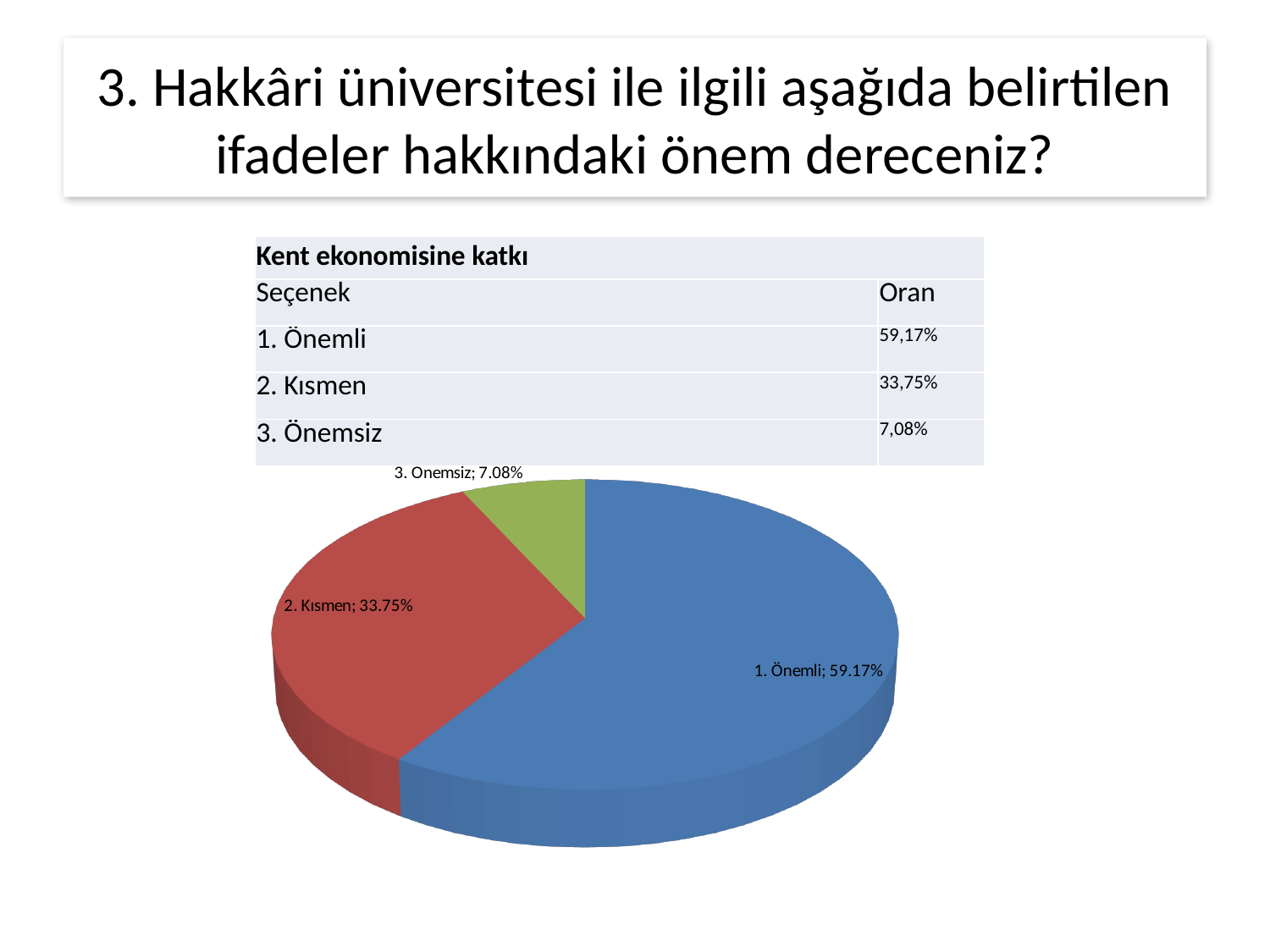
What is the value shown for the "1. Önemli" slice of the pie chart? 59.17% What is the difference between the "1. Önemli" and "2. Kısmen" values in the pie chart? 25.42% Which slice of the pie chart is the largest? 1. Önemli How many slices does the pie chart have? 3 Which is larger in the pie chart, "2. Kısmen" or "3. Onemsiz"? 2. Kısmen Which slice of the pie chart is the smallest? 3. Onemsiz What colour is the "2. Kısmen" slice in the pie chart? red What is the value shown for the "3. Onemsiz" slice of the pie chart? 7.08% What kind of chart is shown on the slide? pie chart What is the difference between the "2. Kısmen" and "3. Onemsiz" values in the pie chart? 26.67% What share of the pie does the "1. Önemli" slice represent? 59.17% What is the value shown for the "2. Kısmen" slice of the pie chart? 33.75%